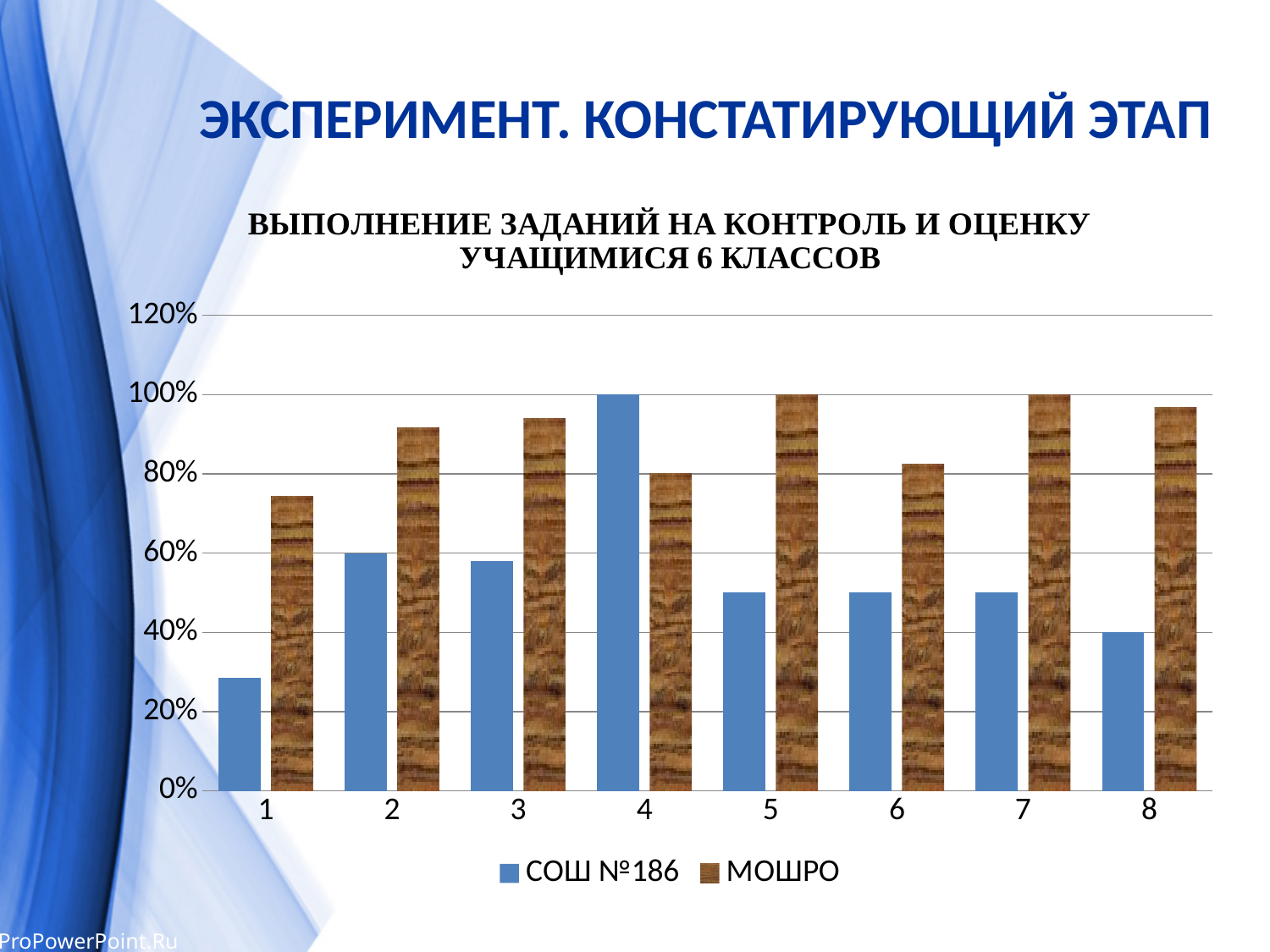
Which series is named first in the legend? СОШ №186 In category 4, what is the difference between the СОШ №186 value and the МОШРО value? 20% What is the value for СОШ №186 in category 4? 100% How many categories are shown on the x axis? 8 What is the value for МОШРО in category 4? 80% What kind of chart is shown on the slide? bar chart How many series does the legend list? 2 In which category is the value for СОШ №186 lowest? 1 In which category is the value for СОШ №186 highest? 4 What is the value for СОШ №186 in category 8? 40% What is the value for СОШ №186 in category 2? 60% Is the value for МОШРО in category 1 greater or less than 60%? greater